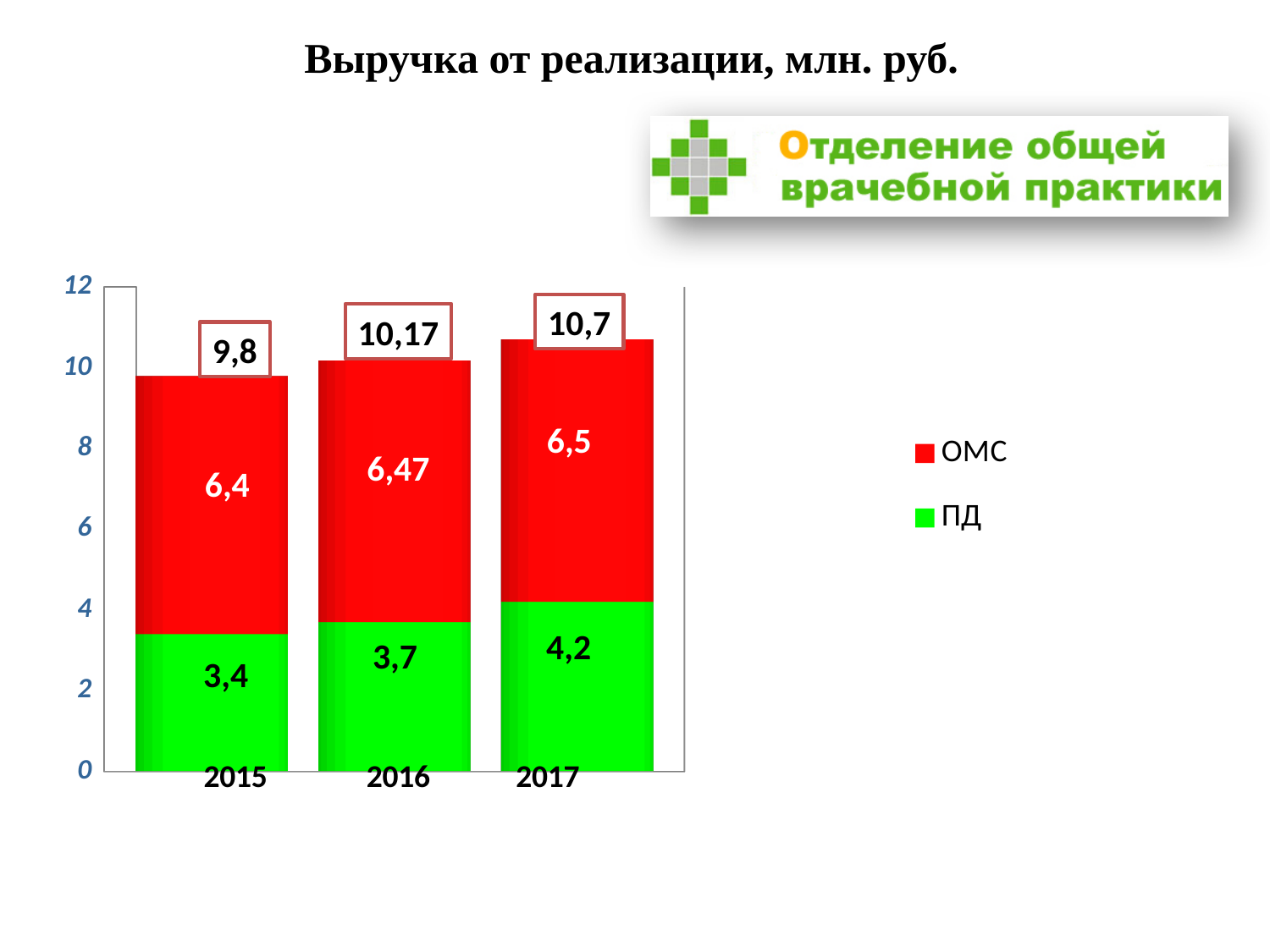
Which year has the lowest total revenue? 2015 What is the ПД value for 2017? 4,2 Do the total values rise or fall from 2015 to 2017? rise What is the ОМС value for 2016? 6,47 What kind of chart is shown? stacked bar chart What is the total shown above the 2015 bar? 9,8 Which year has the highest ПД value? 2017 Which is larger: the ОМС value for 2015 or the ОМС value for 2017? 2017 Is the total for 2016 greater or less than 10? greater How many years are shown on the x axis? 3 How many series does the legend list? 2 What is the difference between the ПД values for 2017 and 2015? 0,8